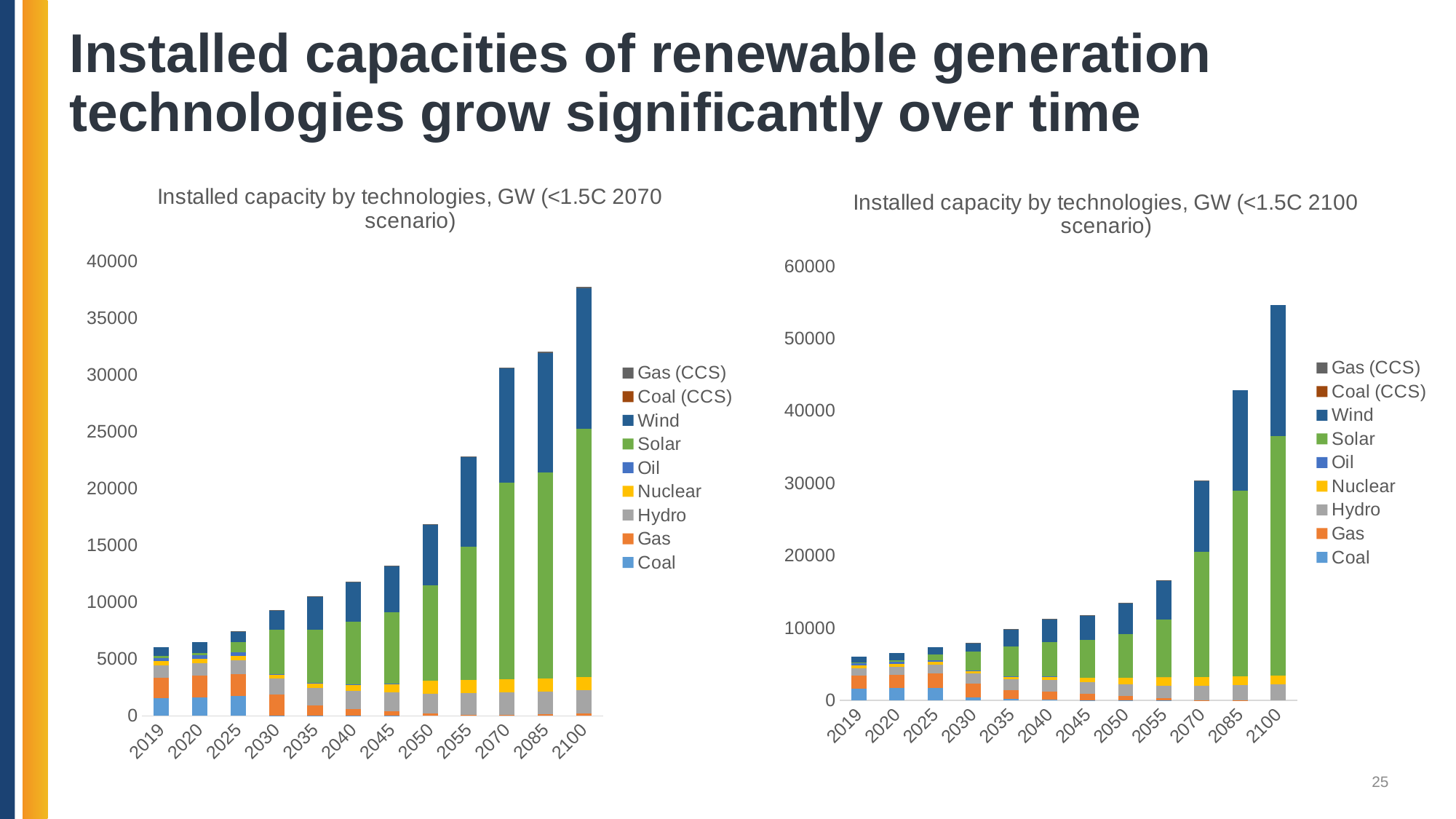
In the left chart (<1.5C 2070 scenario), does the total installed capacity rise or fall from 2019 to 2100? Rise In the right chart (<1.5C 2100 scenario), is the total installed capacity for 2100 greater or less than 50000? greater In the right chart (<1.5C 2100 scenario), which year has the lowest total installed capacity? 2019 In the left chart (<1.5C 2070 scenario), is the total installed capacity for 2100 greater or less than 35000? greater In the right chart (<1.5C 2100 scenario), how many series does the legend list? 9 In the left chart (<1.5C 2070 scenario), which year has the highest total installed capacity? 2100 In the right chart (<1.5C 2100 scenario), which series is shown in green in the legend? Solar In the right chart (<1.5C 2100 scenario), is the total installed capacity for 2055 greater or less than 20000? less What type of chart is the left chart, 'Installed capacity by technologies, GW (<1.5C 2070 scenario)'? Stacked bar chart In the right chart (<1.5C 2100 scenario), which year has the larger total installed capacity, 2070 or 2085? 2085 In the left chart (<1.5C 2070 scenario), how many years are shown on the x axis? 12